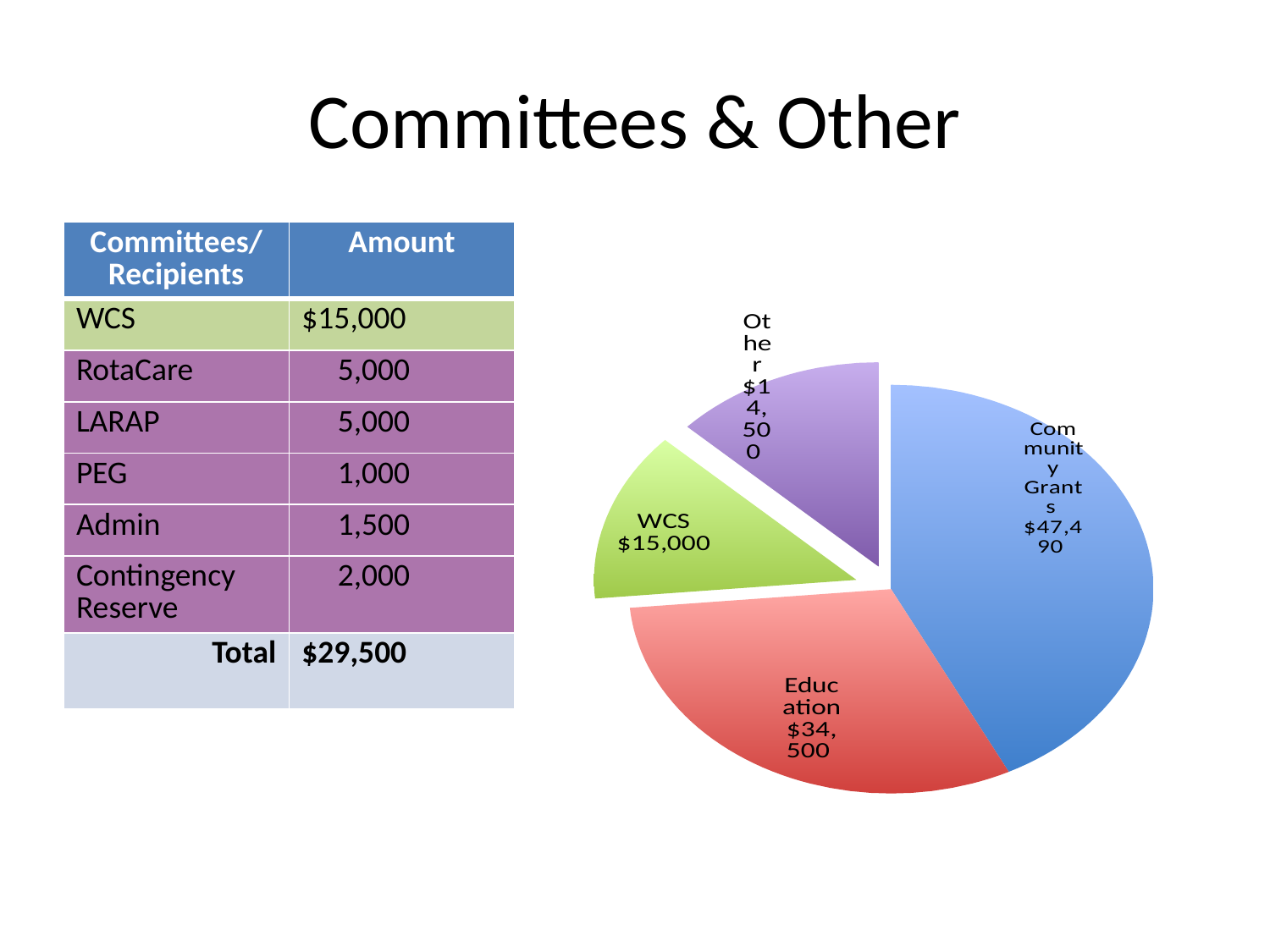
How many slices does the pie chart have? 4 What is the value shown for Education in the pie chart? $34,500 Which slice of the pie chart is the largest? Community Grants What kind of chart is shown on the slide? pie chart In the pie chart, which is larger, WCS or Other? WCS What is the difference between the Education and WCS values in the pie chart? $19,500 What is the difference between the Community Grants and Education values in the pie chart? $12,990 Which slice of the pie chart is the smallest? Other What is the value shown for WCS in the pie chart? $15,000 What colour is the Education slice in the pie chart? red What is the value shown for Other in the pie chart? $14,500 What is the value shown for Community Grants in the pie chart? $47,490